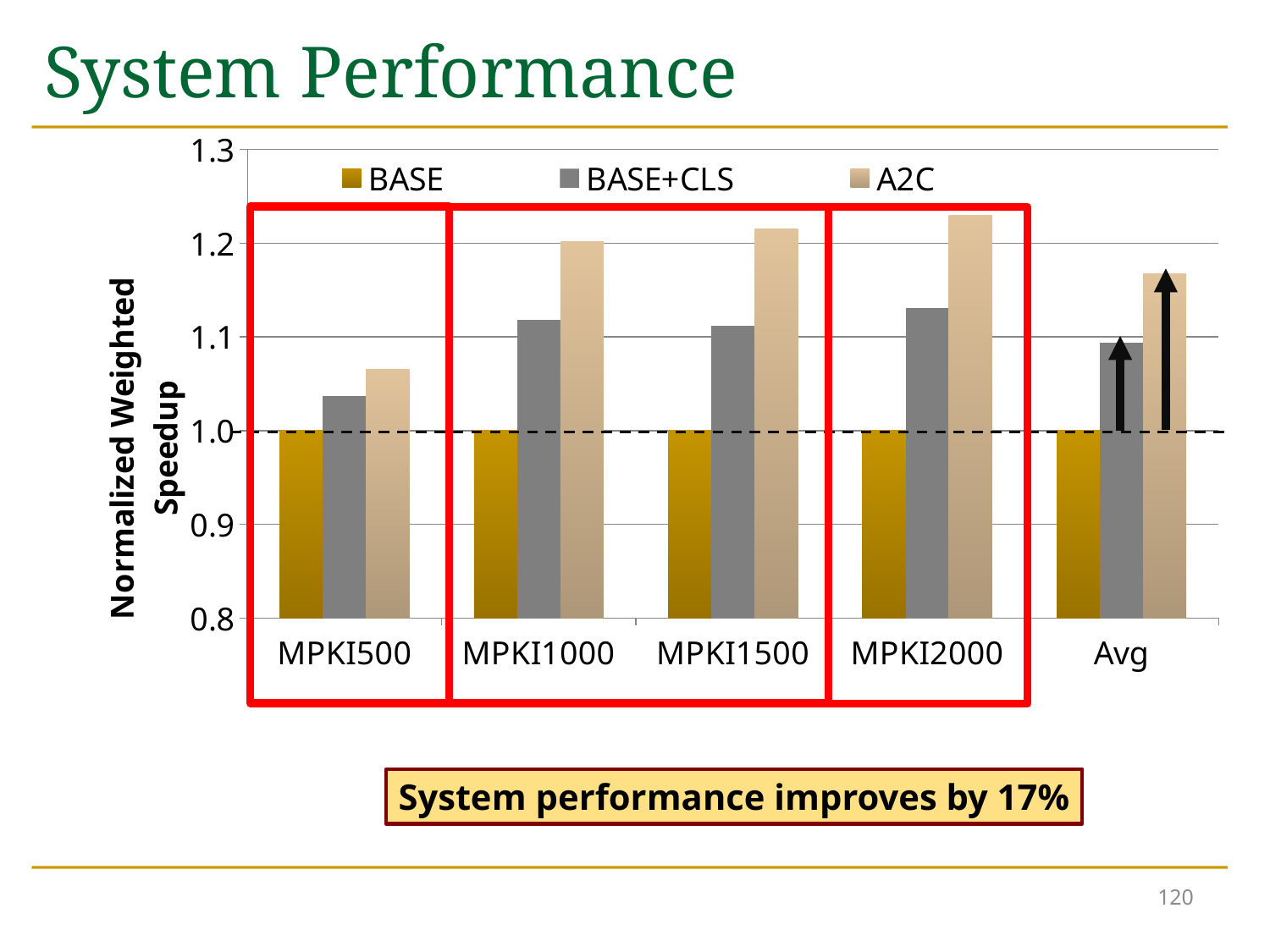
How many series does the legend list? 3 Is the A2C value for MPKI500 greater or less than 1.1? less For MPKI1000, which is larger: the A2C value or the BASE+CLS value? A2C What kind of chart is shown on the slide? bar chart Is the A2C value for MPKI2000 greater or less than 1.2? greater Do the A2C values rise or fall from MPKI500 to MPKI2000? rise How many categories are shown on the x axis? 5 What is the BASE value for MPKI500? 1.0 What is the label of the y axis? Normalized Weighted Speedup Is the A2C value for Avg greater or less than 1.2? less For which category is the A2C value lowest? MPKI500